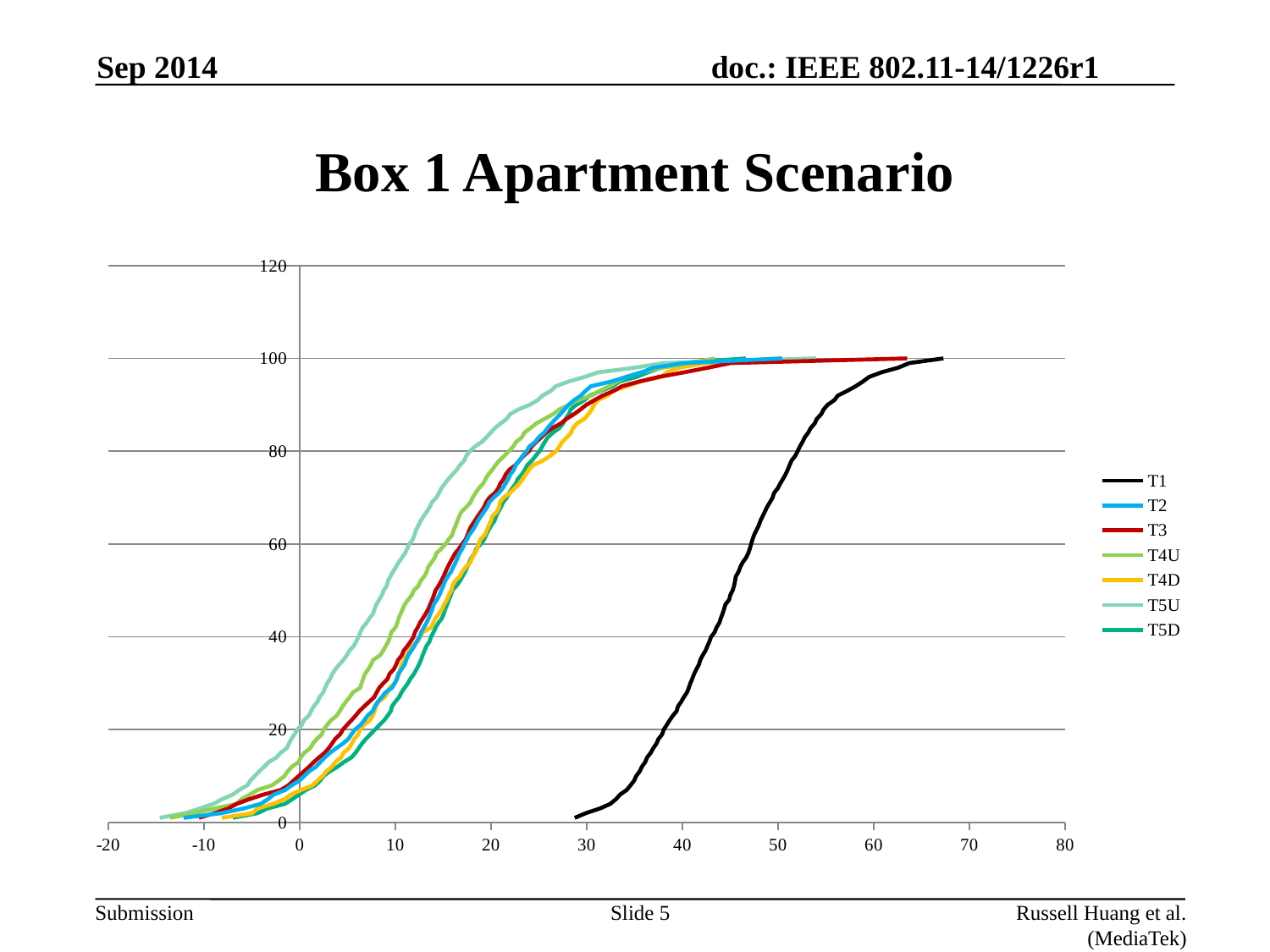
What kind of chart is shown on the slide? line chart Is the value of the T1 series at x = 50 greater or less than 60? greater Which series is drawn in black? T1 Is the value of the T1 series at x = 30 greater or less than 20? less How many series does the legend list? 7 What is the title of the chart? Box 1 Apartment Scenario Is the value of the T1 series at x = 40 greater or less than 40? less Do the values of the T1 series rise or fall as the x axis increases? rise At x = 10, which series has the larger value, T5U or T4D? T5U At x = 40, which series has the larger value, T1 or T2? T2